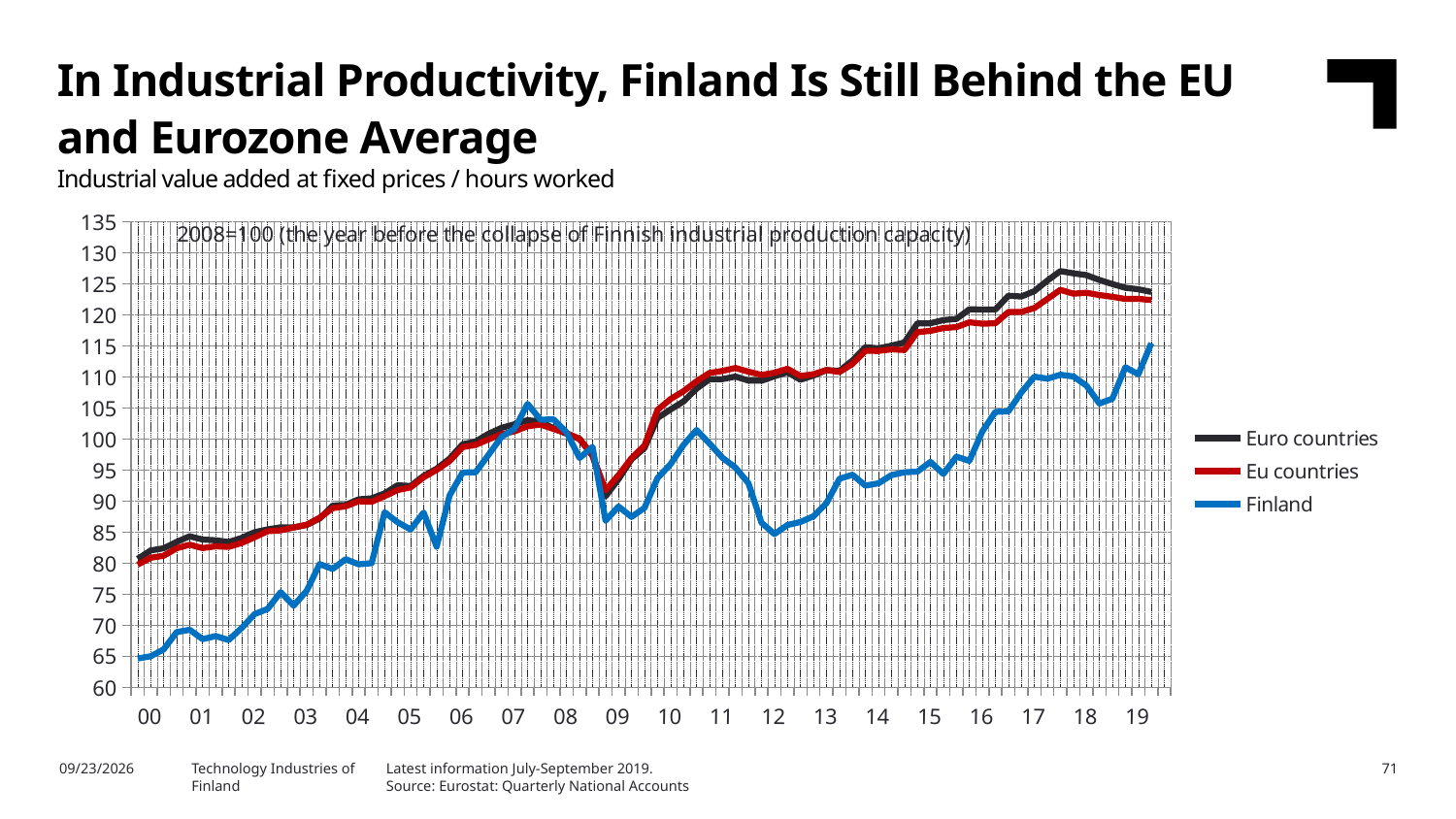
What kind of chart is shown on the slide? Line chart How many series does the legend list? 3 Which series is higher in 12, Finland or Eu countries? Eu countries Which series are listed in the legend? Euro countries, Eu countries, Finland Does the Finland line rise or fall overall from 12 to 19? Rise What base year is the index set to 100, according to the note on the chart? 2008 Is the value for Finland in 12 greater or less than 90? less Is the value for Euro countries at the end of the series (19) greater or less than 120? greater Which series is higher at the end of the series (19), Finland or Euro countries? Euro countries Is the value for Finland at the end of the series (19) greater or less than 105? greater How many year labels are shown on the x axis? 20